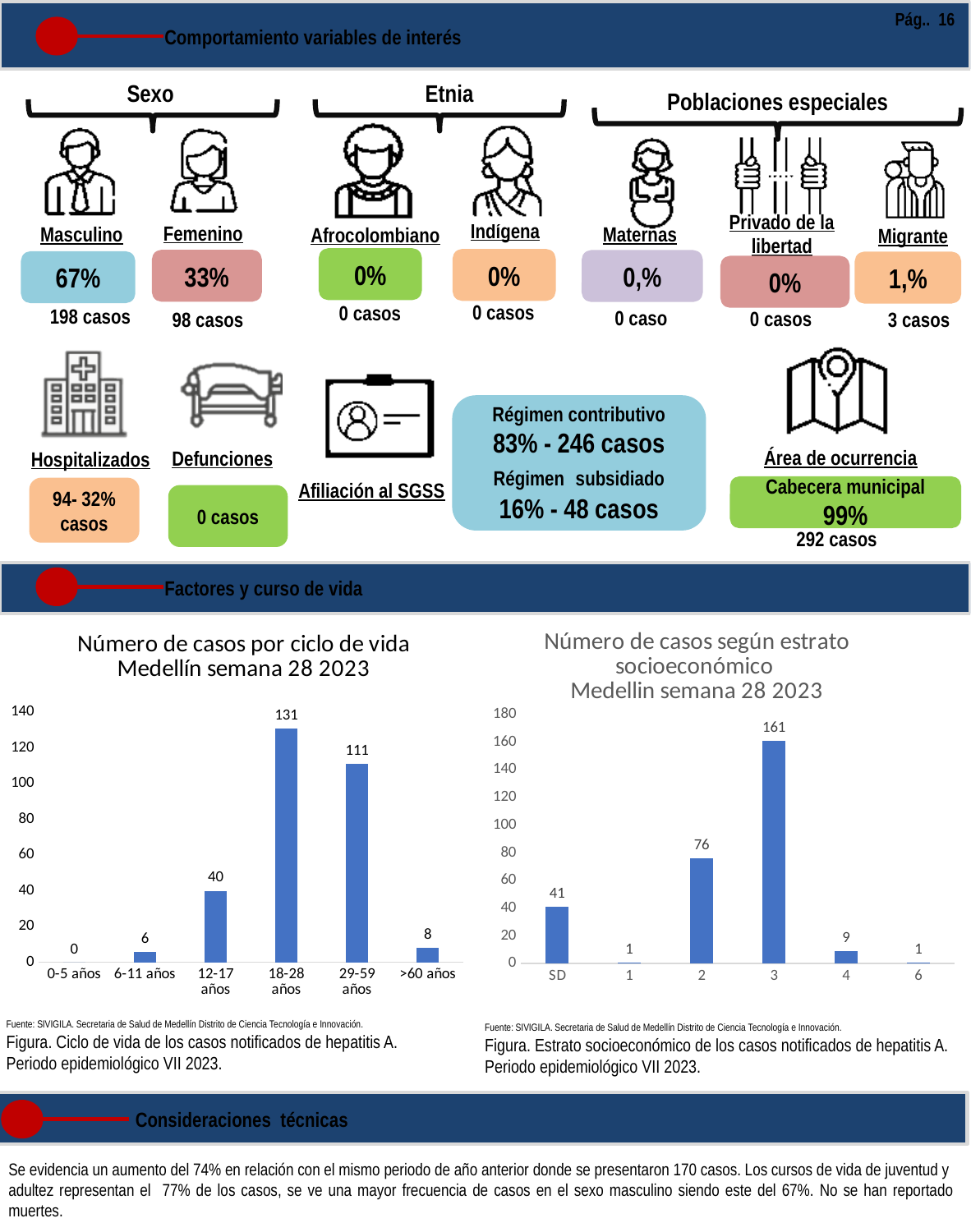
In the chart 'Número de casos por ciclo de vida Medellín semana 28 2023', how many age groups are shown on the x axis? 6 What type of chart is 'Número de casos según estrato socioeconómico Medellin semana 28 2023'? Bar chart In the chart 'Número de casos según estrato socioeconómico Medellin semana 28 2023', what is the difference between the values for estrato 3 and estrato 2? 85 In the chart 'Número de casos por ciclo de vida Medellín semana 28 2023', how many cases are shown for the 18-28 años group? 131 In the chart 'Número de casos según estrato socioeconómico Medellin semana 28 2023', how many cases are shown for the SD category? 41 In the chart 'Número de casos por ciclo de vida Medellín semana 28 2023', which is larger, the value for 12-17 años or the value for >60 años? 12-17 años In the chart 'Número de casos por ciclo de vida Medellín semana 28 2023', which age group has the highest number of cases? 18-28 años In the chart 'Número de casos según estrato socioeconómico Medellin semana 28 2023', how many cases are shown for estrato 3? 161 In the chart 'Número de casos por ciclo de vida Medellín semana 28 2023', what is the difference between the 18-28 años and 29-59 años values? 20 In the chart 'Número de casos según estrato socioeconómico Medellin semana 28 2023', how many categories are shown on the x axis? 6 In the chart 'Número de casos por ciclo de vida Medellín semana 28 2023', which age group has the lowest number of cases? 0-5 años In the chart 'Número de casos según estrato socioeconómico Medellin semana 28 2023', which category has the highest number of cases? 3